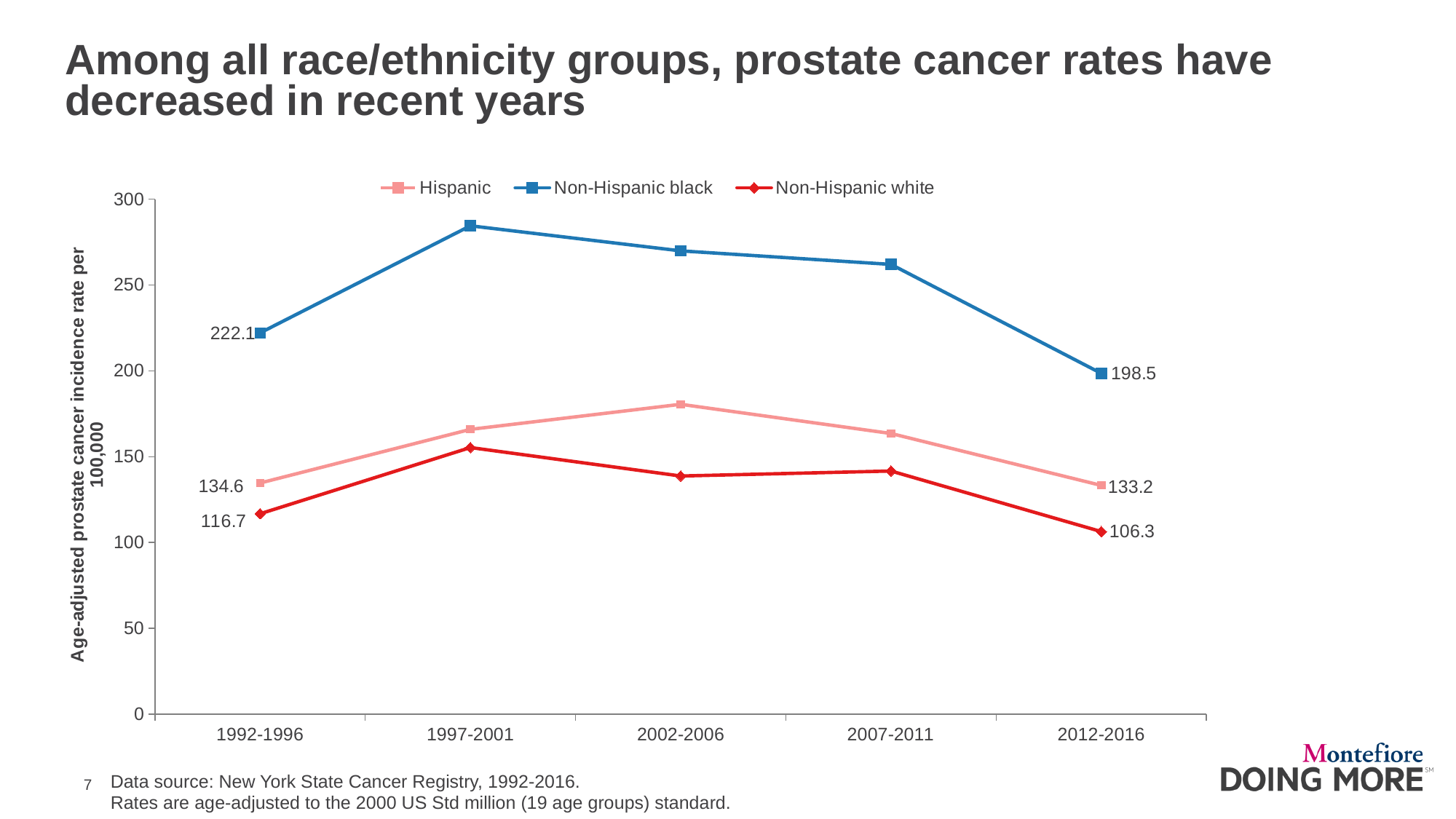
Which group has the highest incidence rate in 2012-2016? Non-Hispanic black How many series does the legend list? 3 Which series is drawn in red? Non-Hispanic white What is the Non-Hispanic black incidence rate for 2012-2016? 198.5 What is the difference between the Hispanic and Non-Hispanic white rates in 2012-2016? 26.9 What is the Non-Hispanic white incidence rate for 1992-1996? 116.7 How many time periods are shown on the x axis? 5 By how much did the Non-Hispanic black rate change from 1992-1996 to 2012-2016? 23.6 What is the Non-Hispanic black incidence rate for 1992-1996? 222.1 Is the Non-Hispanic black value for 1997-2001 greater or less than 250? greater What kind of chart is shown on the slide? Line chart What is the Hispanic incidence rate for 2012-2016? 133.2